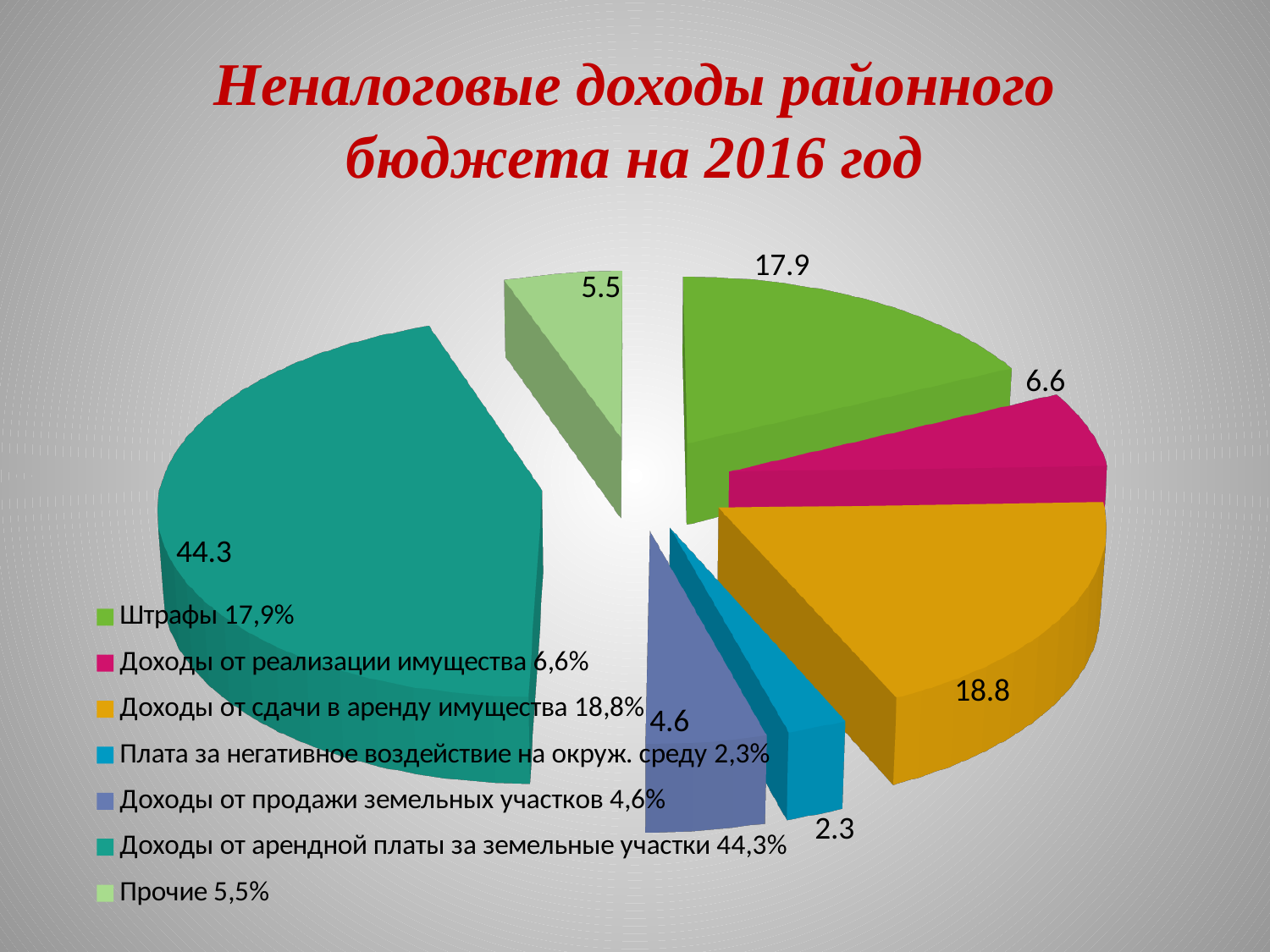
Which category has the smallest slice of the pie? Плата за негативное воздействие на окруж. среду Which category has the largest slice of the pie? Доходы от арендной платы за земельные участки What is the difference between the values for Штрафы and Доходы от реализации имущества? 11.3 What is the difference between the values for Доходы от арендной платы за земельные участки and Доходы от сдачи в аренду имущества? 25.5 What is the value shown for Доходы от сдачи в аренду имущества? 18.8 What type of chart is shown on the slide? Pie chart What is the value shown for Штрафы? 17.9 What is the value shown for Прочие? 5.5 Which is larger: Доходы от продажи земельных участков or Доходы от реализации имущества? Доходы от реализации имущества What is the title of the slide? Неналоговые доходы районного бюджета на 2016 год How many categories does the pie chart have? 7 What is the value shown for Плата за негативное воздействие на окруж. среду? 2.3